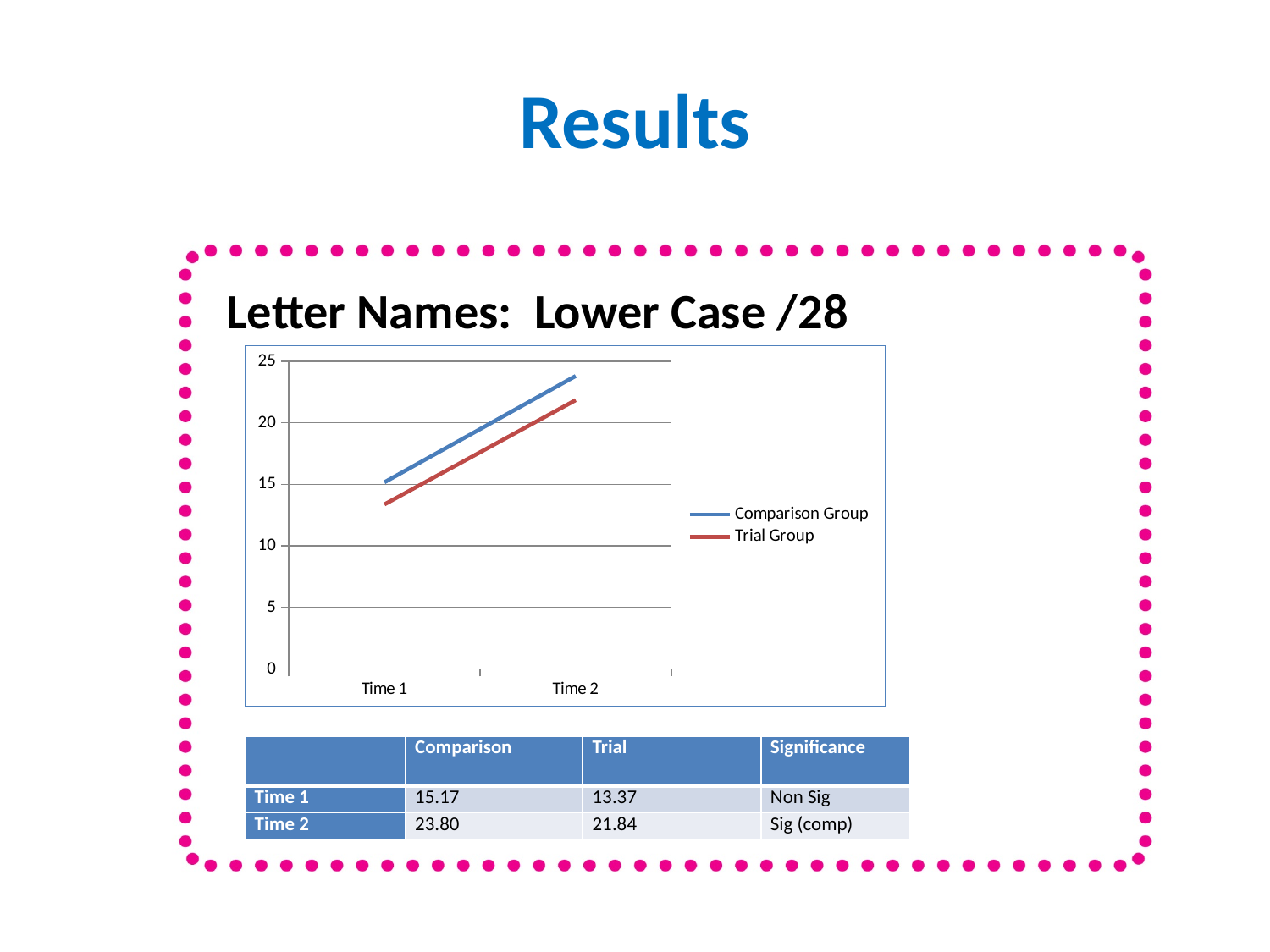
Is the Comparison Group value at Time 1 greater or less than 15? greater What kind of chart is shown on the slide? line chart Is the Trial Group value at Time 1 greater or less than 15? less According to the table below the chart, what is the Trial value at Time 1? 13.37 How many time points are plotted on the x axis of the chart? 2 Is the Trial Group value at Time 2 greater or less than 20? greater Does the Trial Group line rise or fall from Time 1 to Time 2? rise Which group has the higher value at Time 2? Comparison Group What is the title shown above the chart? Letter Names: Lower Case /28 Which group has the lower value at Time 1? Trial Group How many series does the chart legend list? 2 According to the table below the chart, what is the Comparison value at Time 2? 23.80